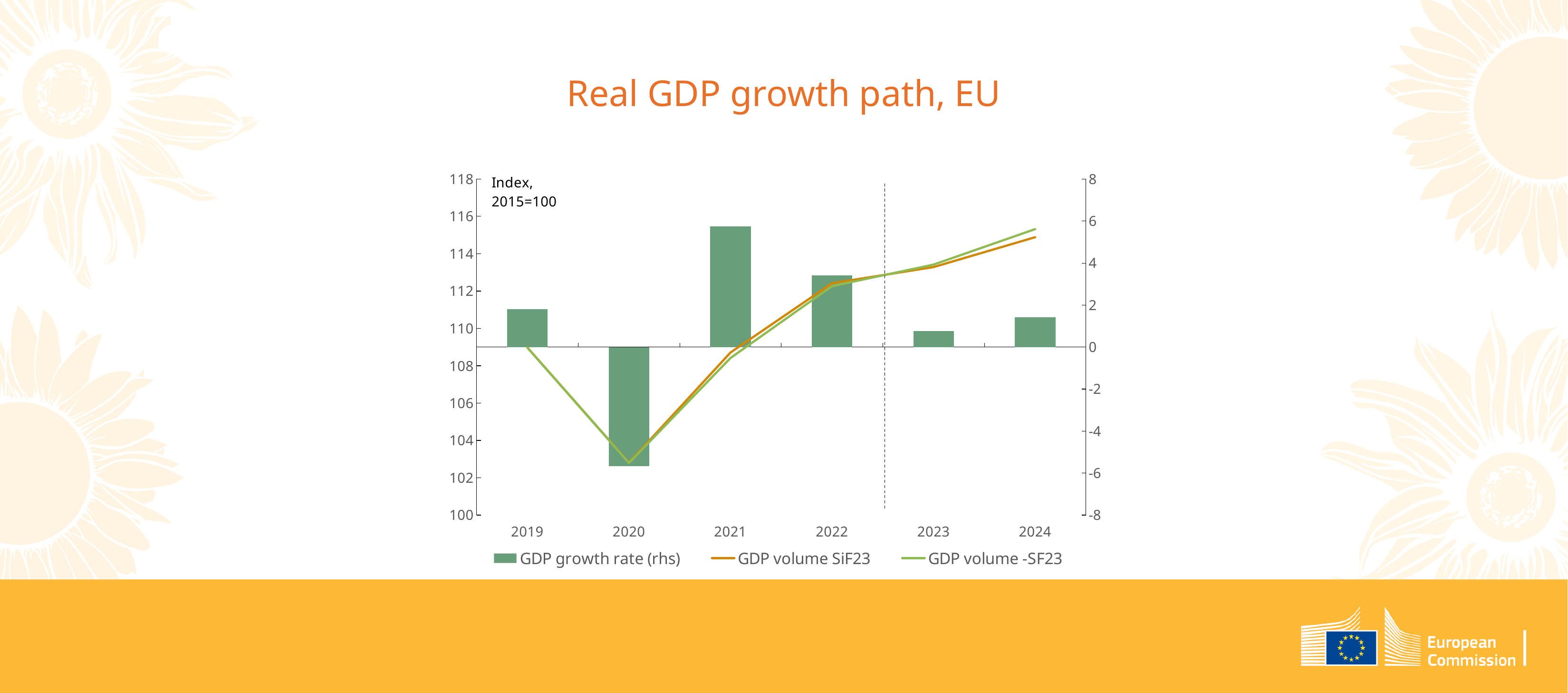
What is the title of the chart? Real GDP growth path, EU In which year is the GDP growth rate bar the lowest? 2020 Is the GDP growth rate for 2023 greater or less than 2? less Is the GDP volume SiF23 value for 2020 greater or less than 104? less How many years are shown on the x axis? 6 Is the GDP growth rate for 2020 greater or less than -4? less In which year is the GDP growth rate bar the highest? 2021 Which year has a larger GDP growth rate bar, 2019 or 2023? 2019 How many series does the legend list? 3 What kind of chart is this? Combined bar and line chart Do the GDP volume lines rise or fall from 2020 to 2024? rise